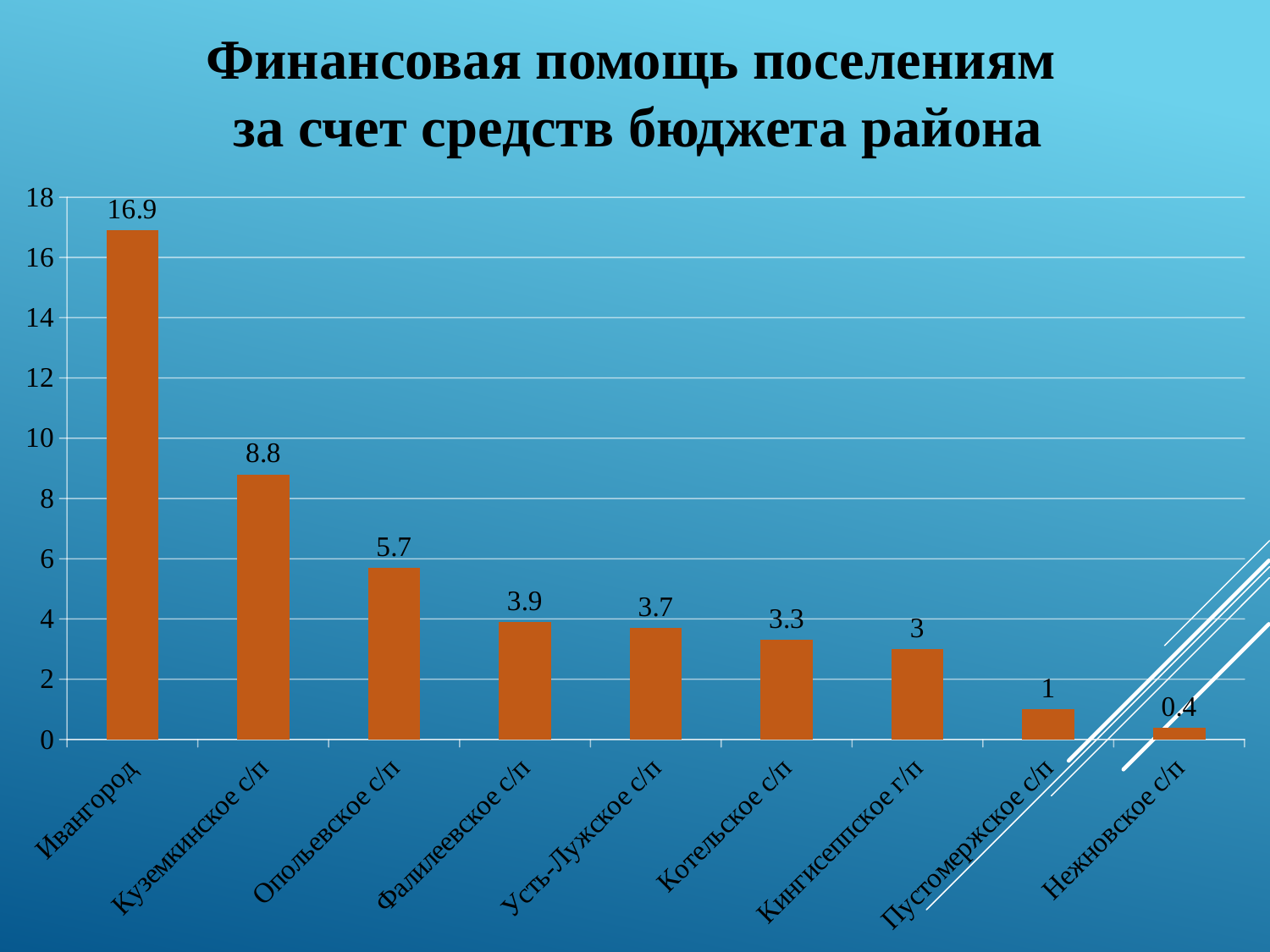
Which category has the lowest value? Нежновское с/п What is the title of the chart? Финансовая помощь поселениям за счет средств бюджета района What is the difference between the values for Ивангород and Куземкинское с/п? 8.1 Which is larger, the value for Фалилеевское с/п or the value for Котельское с/п? Фалилеевское с/п Do the values rise or fall from left to right along the x axis? fall Which category has the highest value? Ивангород What is the value for Ивангород? 16.9 How many categories are shown on the x axis? 9 Is the value for Куземкинское с/п greater or less than 10? less What is the value for Опольевское с/п? 5.7 What kind of chart is shown on the slide? bar chart What is the value for Кингисеппское г/п? 3